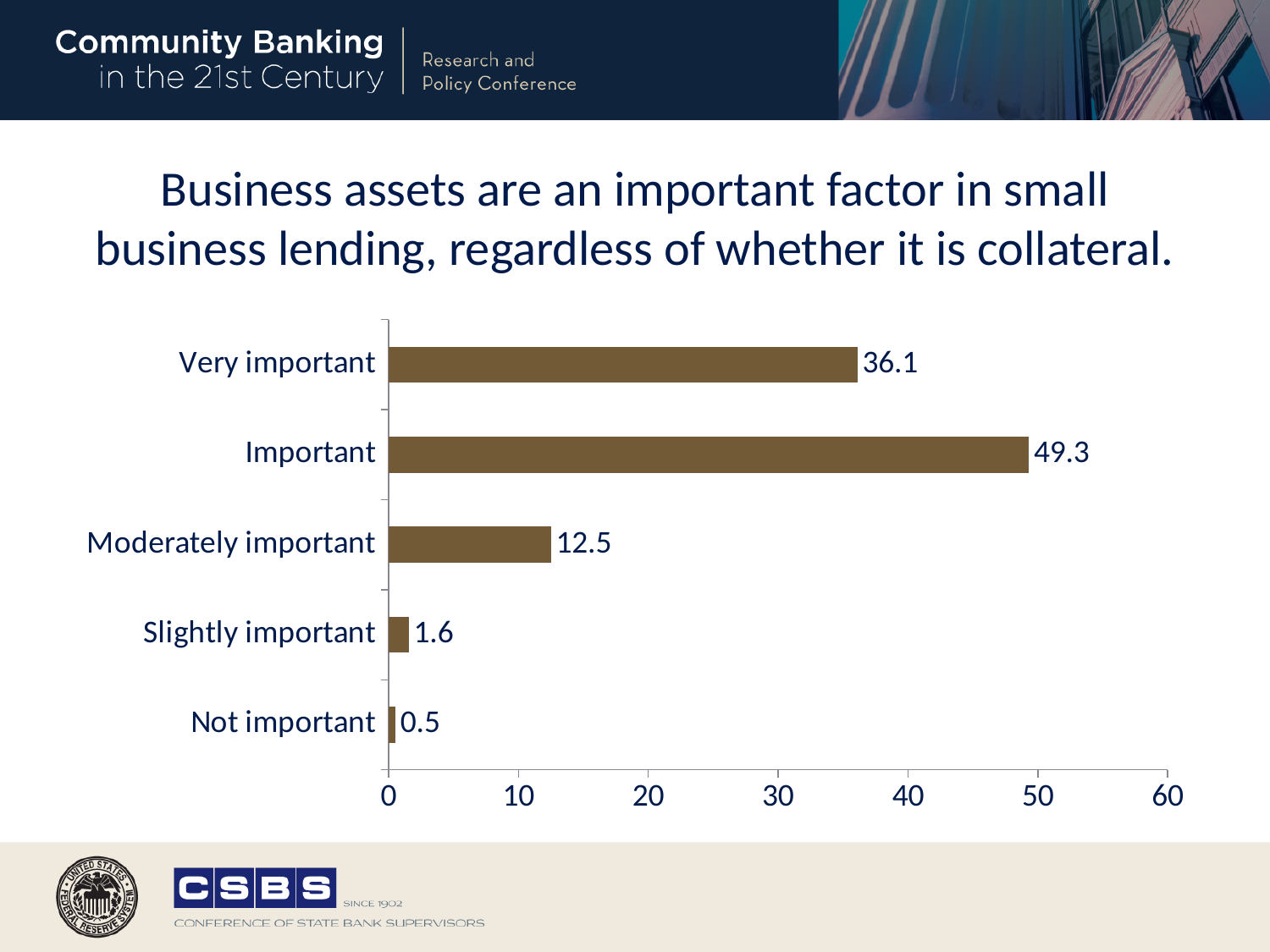
What kind of chart is shown on the slide? Bar chart What is the value for Very important? 36.1 Which category has the highest value? Important Which is larger, the value for Very important or the value for Moderately important? Very important What is the value for Not important? 0.5 What is the value for Important? 49.3 What is the value for Moderately important? 12.5 Which category has the lowest value? Not important Is the value for Important greater or less than 40? greater How many categories are shown in the chart? 5 What is the difference between the values for Important and Very important? 13.2 What is the value for Slightly important? 1.6